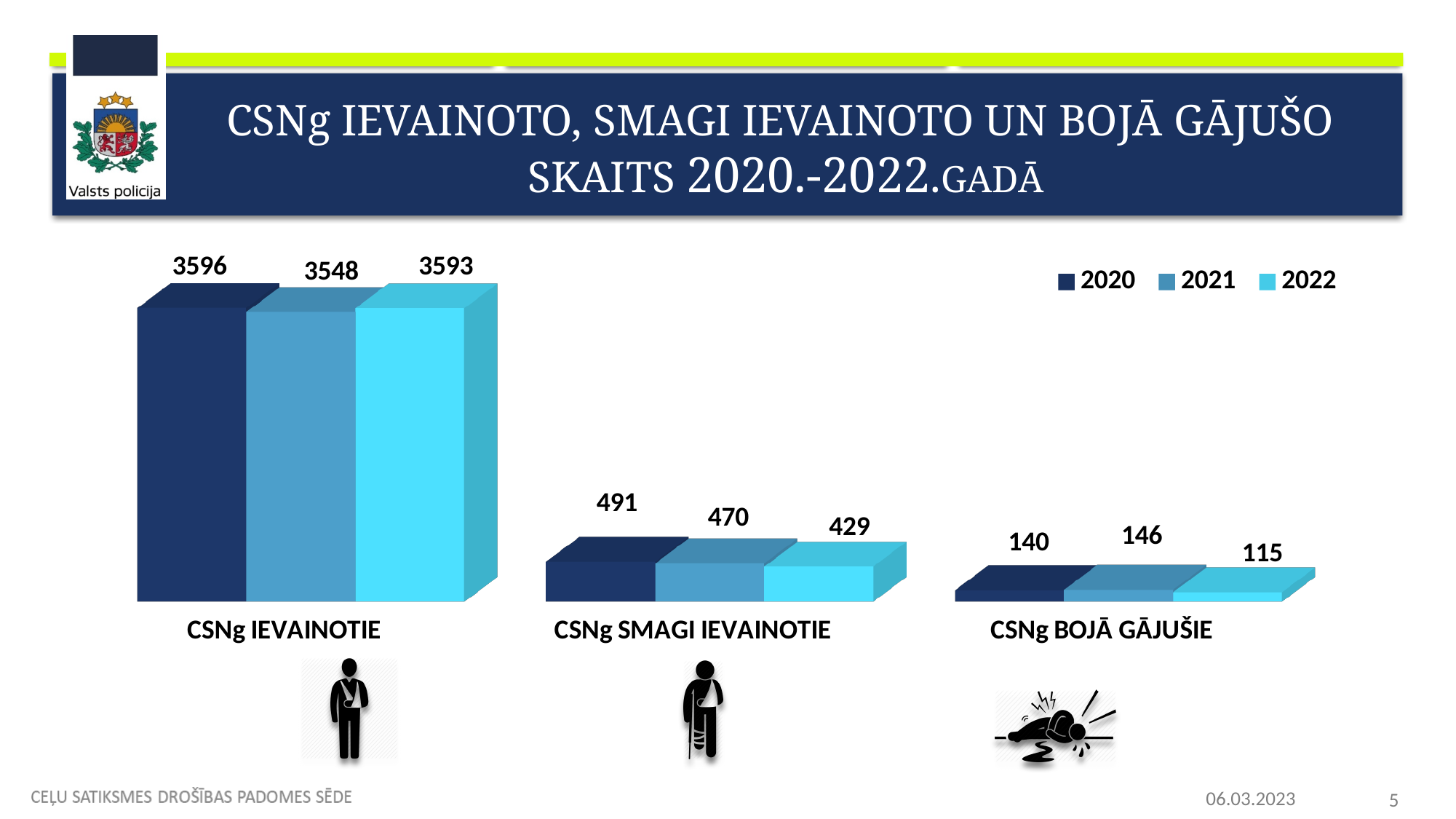
Do the values in the CSNg SMAGI IEVAINOTIE category rise or fall from 2020 to 2022? Fall What is the difference between the 2020 and 2021 values in the CSNg IEVAINOTIE category? 48 How many series does the legend list? 3 Which year has the highest value in the CSNg SMAGI IEVAINOTIE category? 2020 What is the value for 2020 in the CSNg IEVAINOTIE category? 3596 What is the value for 2021 in the CSNg BOJĀ GĀJUŠIE category? 146 Which year has the lowest value in the CSNg BOJĀ GĀJUŠIE category? 2022 What is the difference between the 2021 and 2022 values in the CSNg BOJĀ GĀJUŠIE category? 31 What is the value for 2022 in the CSNg SMAGI IEVAINOTIE category? 429 How many categories are shown on the x axis? 3 Which is larger: the 2020 value or the 2021 value in the CSNg BOJĀ GĀJUŠIE category? 2021 What kind of chart is shown on the slide? Bar chart